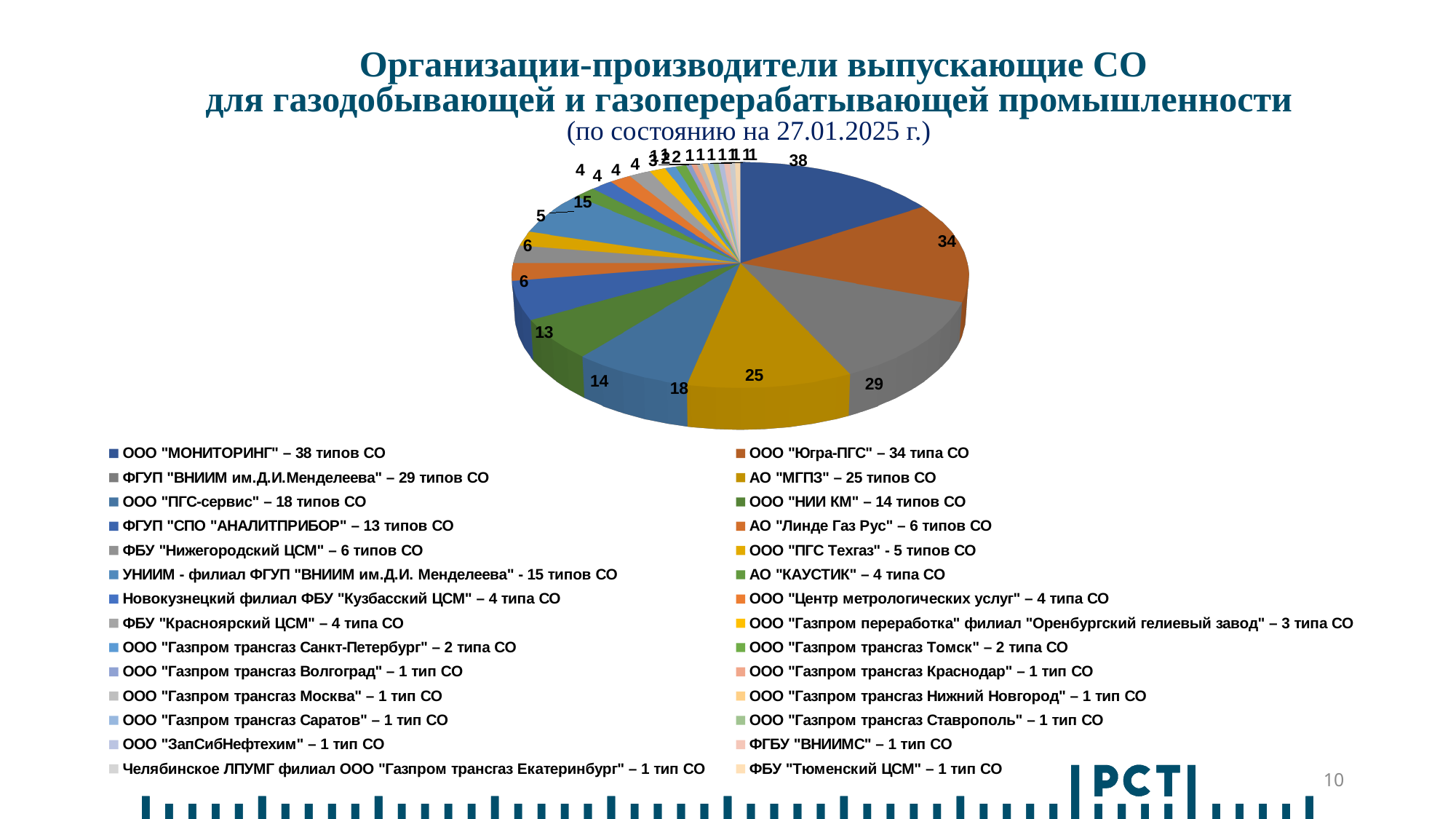
How many types of CO does ООО "МОНИТОРИНГ" produce according to the chart? 38 What is the difference between the values for ФГУП "ВНИИМ им.Д.И.Менделеева" and ООО "ПГС-сервис"? 11 What is the value shown for АО "МГПЗ"? 25 Which organisation has the largest slice of the pie? ООО "МОНИТОРИНГ" As of what date is the data in the chart reported? 27.01.2025 Which is larger: the value for ООО "НИИ КМ" or the value for УНИИМ - филиал ФГУП "ВНИИМ им.Д.И. Менделеева"? УНИИМ - филиал ФГУП "ВНИИМ им.Д.И. Менделеева" Which is larger: the value for АО "МГПЗ" or the value for ООО "ПГС-сервис"? АО "МГПЗ" What is the value shown for ФГУП "СПО "АНАЛИТПРИБОР"? 13 What is the value shown for ООО "Югра-ПГС"? 34 What is the difference between the values for ООО "МОНИТОРИНГ" and ООО "Югра-ПГС"? 4 What kind of chart is shown on the slide? pie chart How many organisations are listed in the chart legend? 28